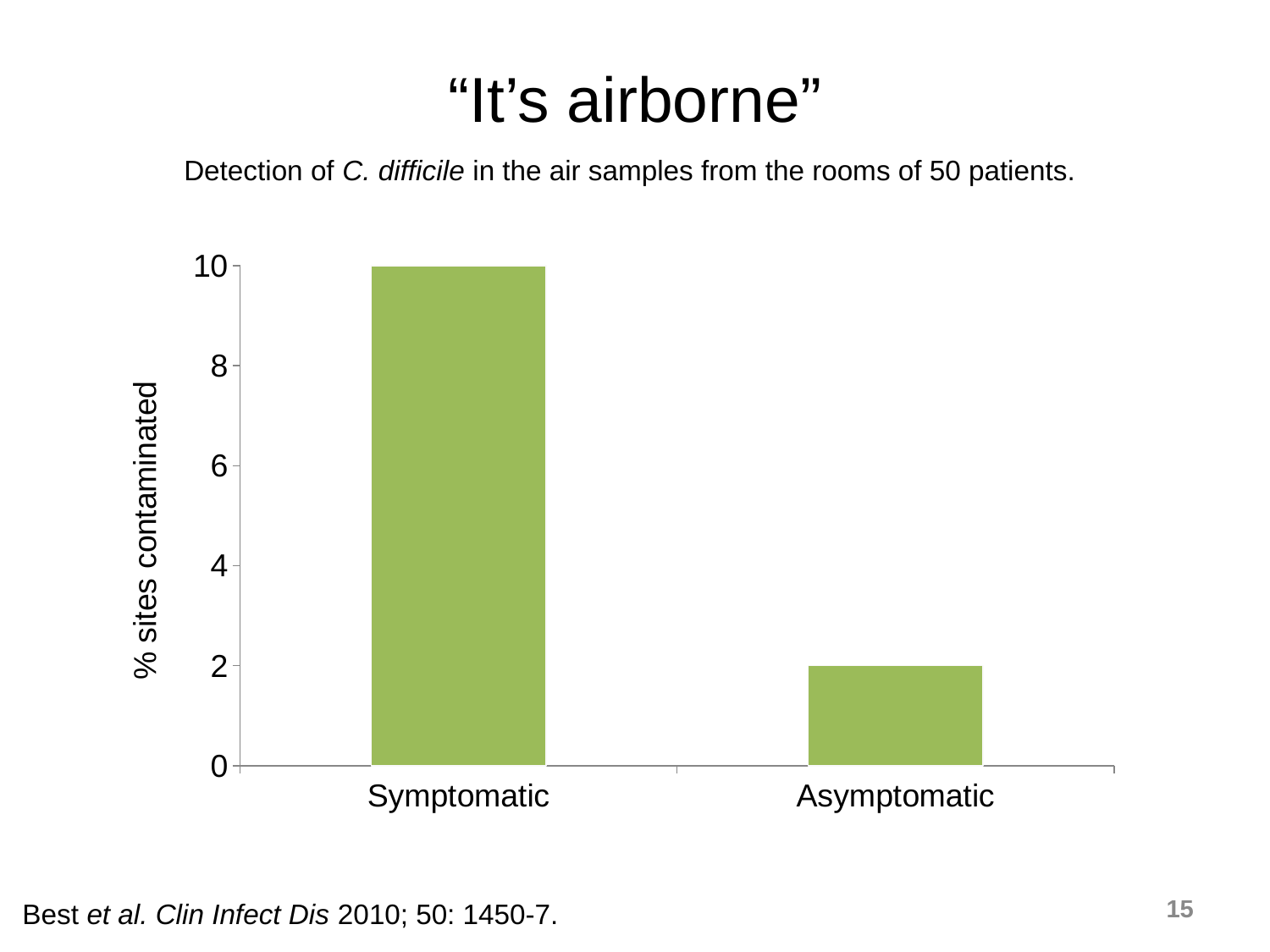
What is the value for Symptomatic? 10 What is the label of the y axis? % sites contaminated Is the value for Symptomatic greater or less than 8? greater What kind of chart is shown on the slide? bar chart Which category has the lowest value? Asymptomatic How many categories are plotted on the x axis? 2 What is the difference between the values for Symptomatic and Asymptomatic? 8 What colour are the bars in the chart? green Which is larger, the value for Symptomatic or the value for Asymptomatic? Symptomatic What is the value for Asymptomatic? 2 Is the value for Asymptomatic greater or less than 4? less Which category has the highest value? Symptomatic